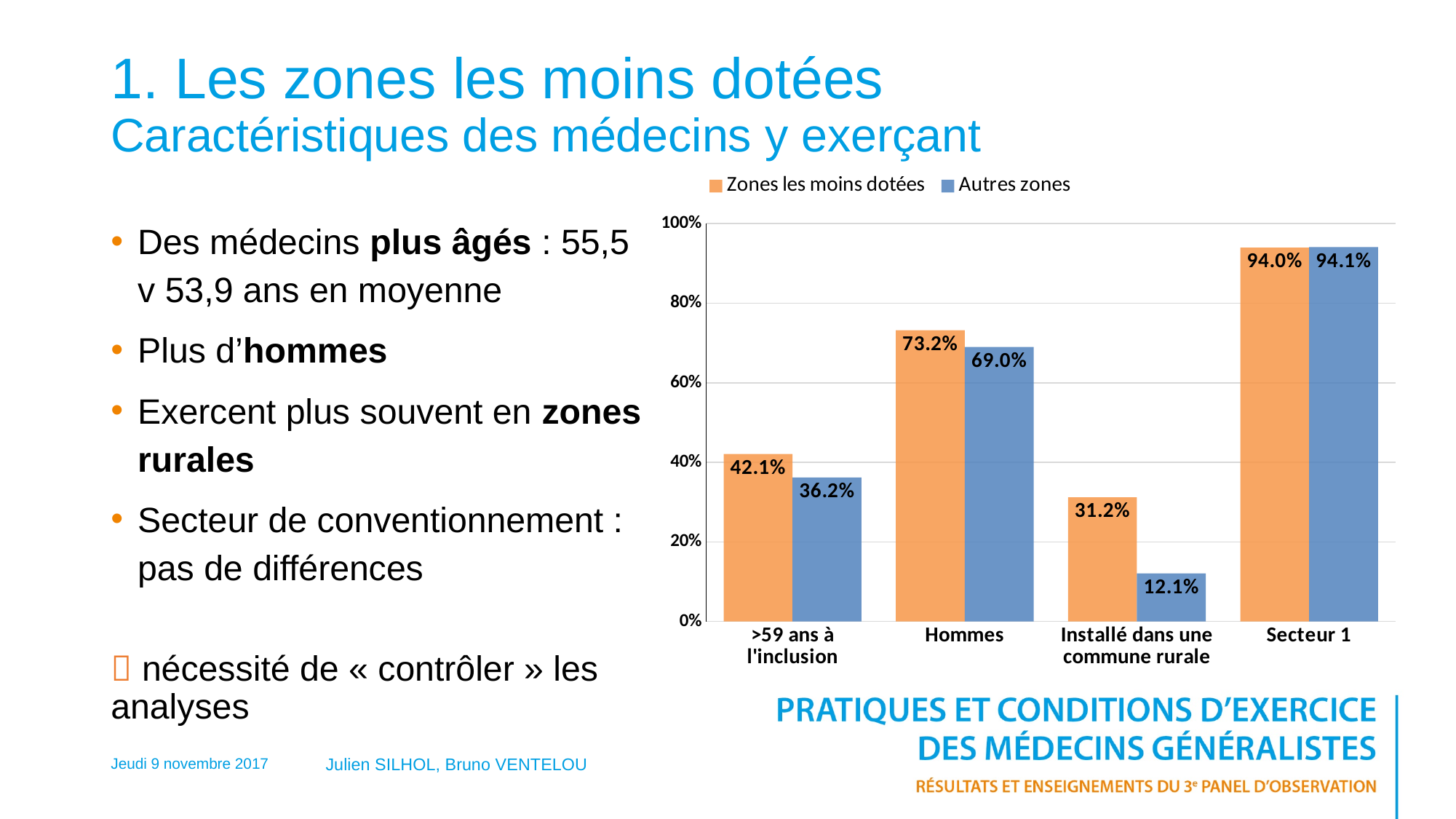
How many categories are shown on the x axis of the chart? 4 What is the value for "Autres zones" in the ">59 ans à l'inclusion" category? 36.2% Which category has the highest value for "Zones les moins dotées"? Secteur 1 What is the value for "Zones les moins dotées" in the "Hommes" category? 73.2% What is the difference between "Zones les moins dotées" and "Autres zones" in the "Installé dans une commune rurale" category? 19.1% Which category has the lowest value for "Autres zones"? Installé dans une commune rurale What kind of chart is shown on the slide? Bar chart How many series does the chart's legend list? 2 What is the value for "Autres zones" in the "Installé dans une commune rurale" category? 12.1% Which is larger in the ">59 ans à l'inclusion" category: "Zones les moins dotées" or "Autres zones"? Zones les moins dotées Is the value for "Autres zones" in the "Hommes" category greater or less than 60%? greater What is the difference between "Zones les moins dotées" and "Autres zones" in the "Hommes" category? 4.2%